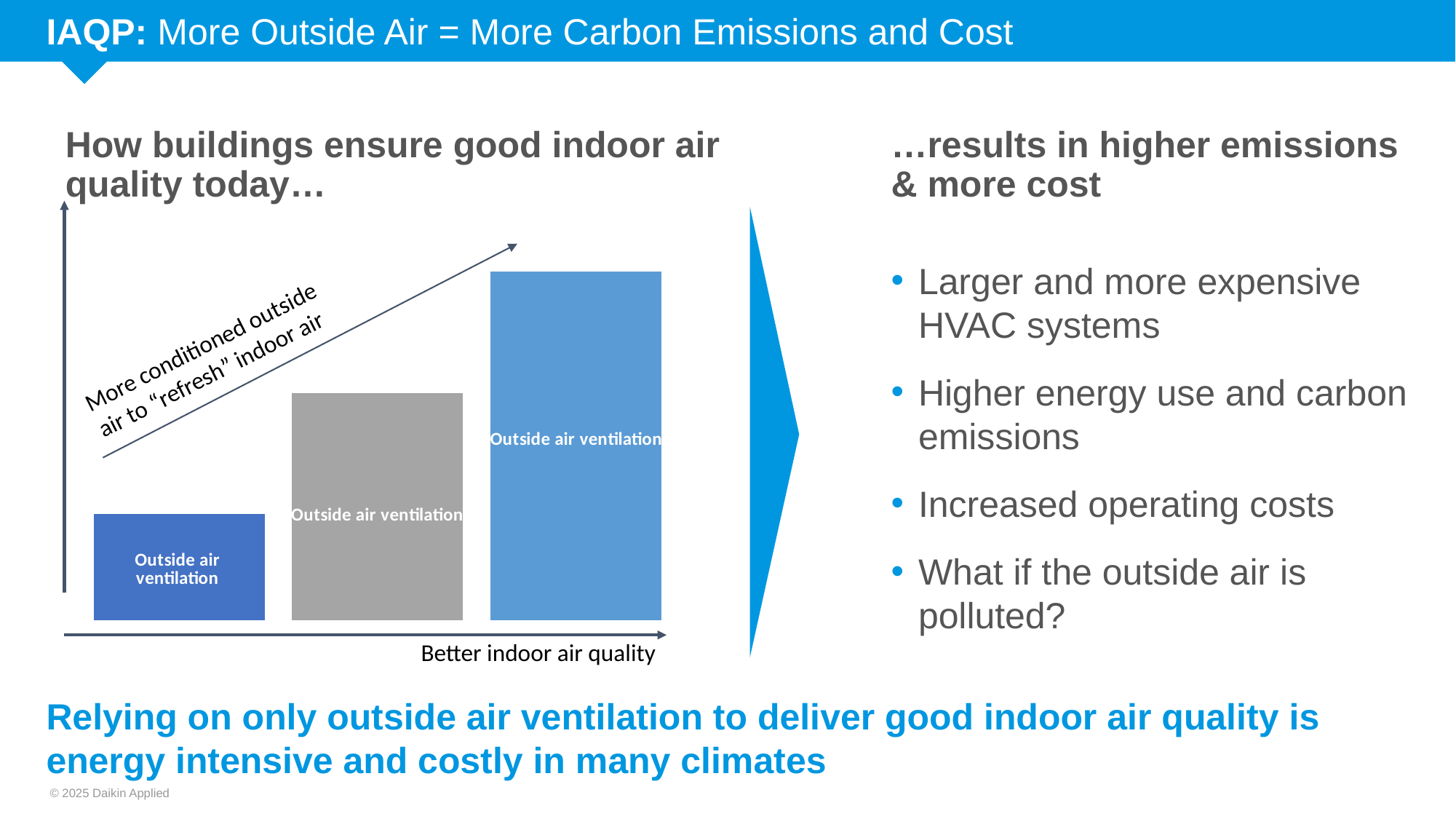
Is the middle (gray) bar taller or shorter than the right (light blue) bar? shorter How many bars does the chart on the left of the slide contain? 3 Which bar in the chart is the tallest: the left, middle, or right bar? right What label is printed inside each of the three bars? Outside air ventilation Which bar in the chart is the shortest: the left, middle, or right bar? left What is the label on the horizontal axis of the chart? Better indoor air quality Do the bar heights in the chart rise or fall from left to right? rise What kind of chart is shown on the left of the slide? bar chart Is the left (dark blue) bar taller or shorter than the middle (gray) bar? shorter